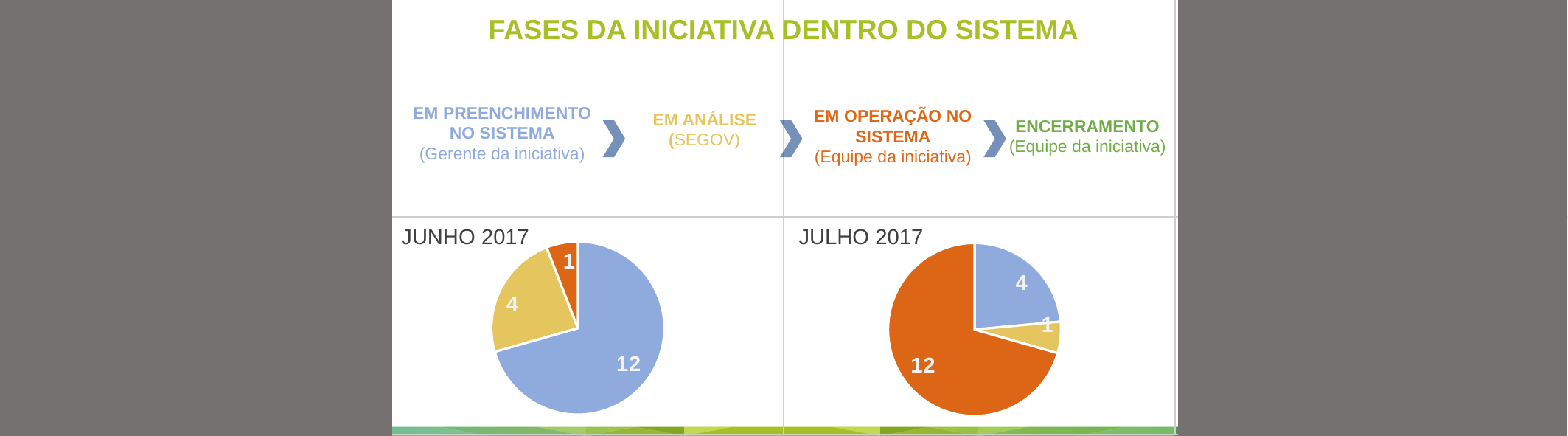
In the JUNHO 2017 chart, what is the value of the orange slice? 1 What is the total of all slices in the JUNHO 2017 pie chart? 17 In the JULHO 2017 chart, is the orange slice larger or smaller than the blue slice? larger In the JULHO 2017 chart, what is the value of the blue slice? 4 In the JUNHO 2017 chart, what is the difference between the blue slice and the yellow slice? 8 How many slices does the JULHO 2017 pie chart have? 3 In the JUNHO 2017 chart, what is the value of the yellow slice? 4 What type of chart is used for JUNHO 2017? pie chart In the JULHO 2017 chart, which slice is the smallest? the yellow slice (1) In the JUNHO 2017 chart, what is the value of the blue slice? 12 In the JUNHO 2017 chart, which slice is the largest? the blue slice (12) In the JULHO 2017 chart, what is the value of the orange slice? 12